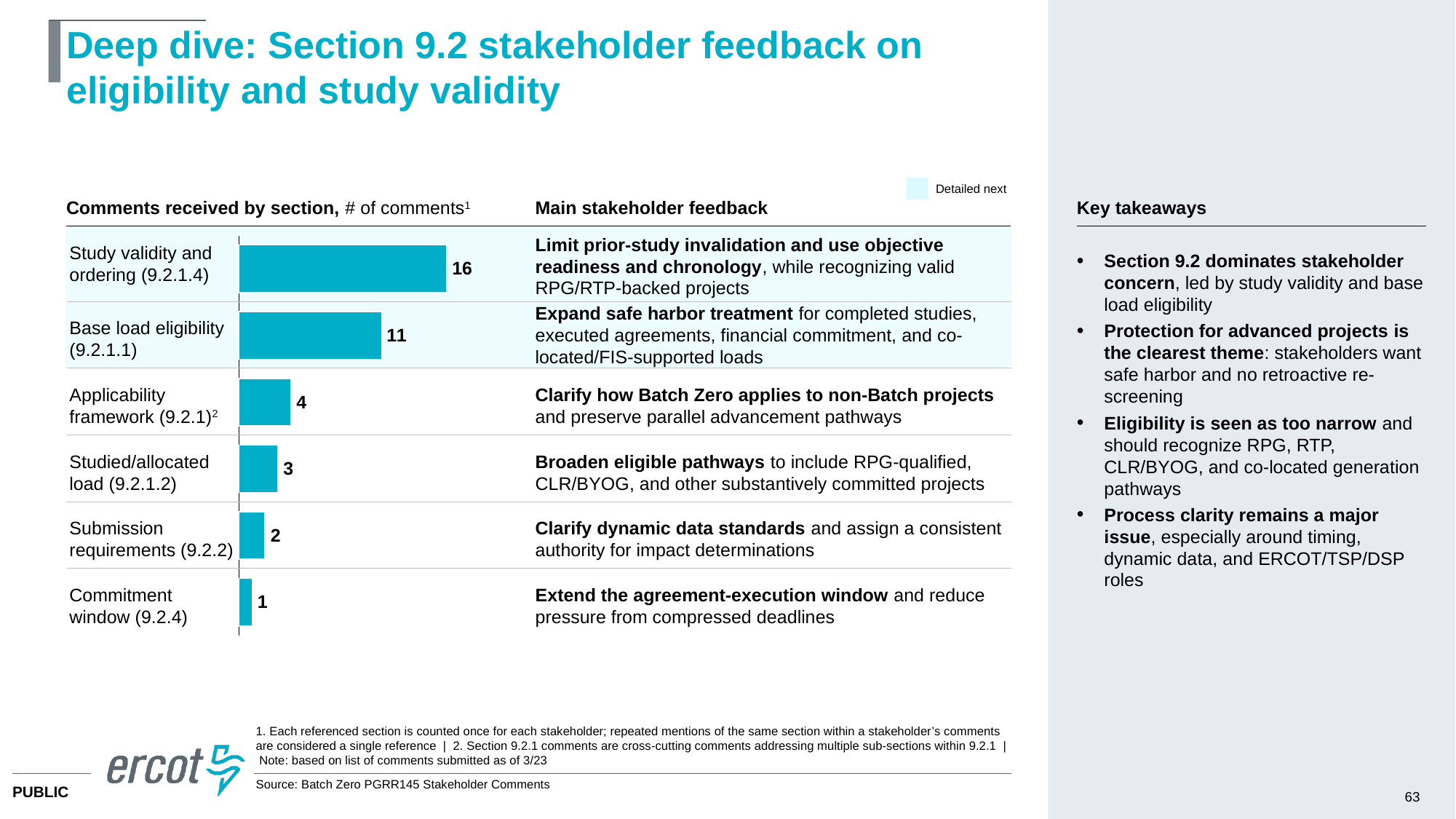
What is the title of the chart? Comments received by section, # of comments Which section received the most comments? Study validity and ordering (9.2.1.4) Which received more comments: Applicability framework (9.2.1) or Studied/allocated load (9.2.1.2)? Applicability framework (9.2.1) How many comments were received for Base load eligibility (9.2.1.1)? 11 How many comments were received for Study validity and ordering (9.2.1.4)? 16 How many comments were received for Submission requirements (9.2.2)? 2 How many sections are shown in the chart? 6 What is the difference in number of comments between Study validity and ordering (9.2.1.4) and Base load eligibility (9.2.1.1)? 5 What is the total number of comments across all six sections shown? 37 Which section received the fewest comments? Commitment window (9.2.4) Which two sections are highlighted as 'Detailed next'? Study validity and ordering (9.2.1.4) and Base load eligibility (9.2.1.1) What kind of chart is used to show comments received by section? Bar chart